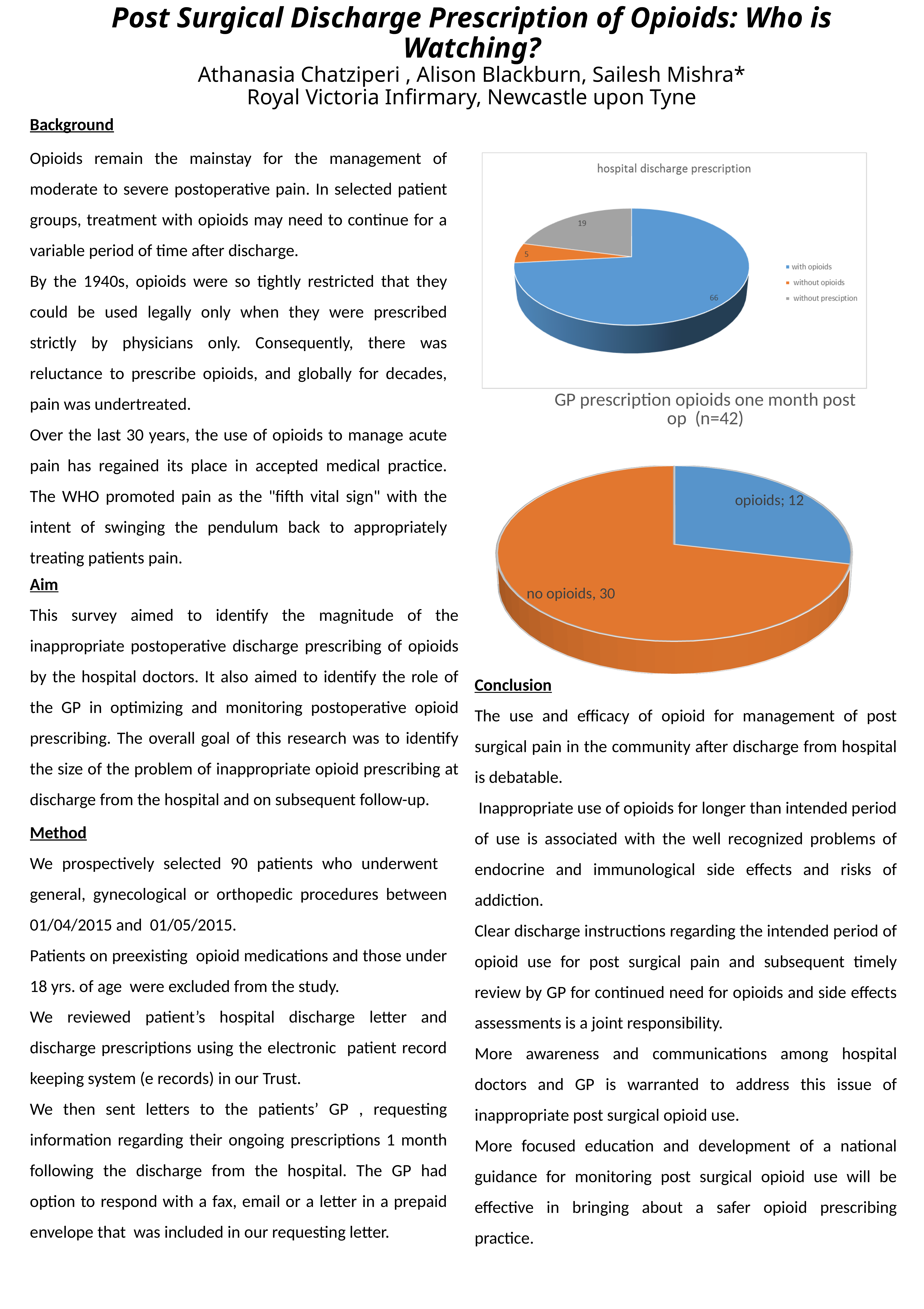
In the 'hospital discharge prescription' chart, what is the value for 'without prescription'? 19 In the 'hospital discharge prescription' chart, what is the difference between 'with opioids' and 'without prescription'? 47 In the 'GP prescription opioids one month post op (n=42)' chart, which is larger, 'opioids' or 'no opioids'? no opioids In the 'hospital discharge prescription' chart, what is the value for 'with opioids'? 66 In the 'GP prescription opioids one month post op (n=42)' chart, what is the value for 'no opioids'? 30 In the 'hospital discharge prescription' chart, how many categories does the legend list? 3 In the 'GP prescription opioids one month post op (n=42)' chart, what is the value for 'opioids'? 12 In the 'hospital discharge prescription' chart, which category has the smallest slice? without opioids In the 'hospital discharge prescription' chart, which category has the largest slice? with opioids In the 'hospital discharge prescription' chart, what is the value for 'without opioids'? 5 In the 'GP prescription opioids one month post op (n=42)' chart, what is the difference between 'no opioids' and 'opioids'? 18 What kind of chart is the 'GP prescription opioids one month post op (n=42)' chart? pie chart